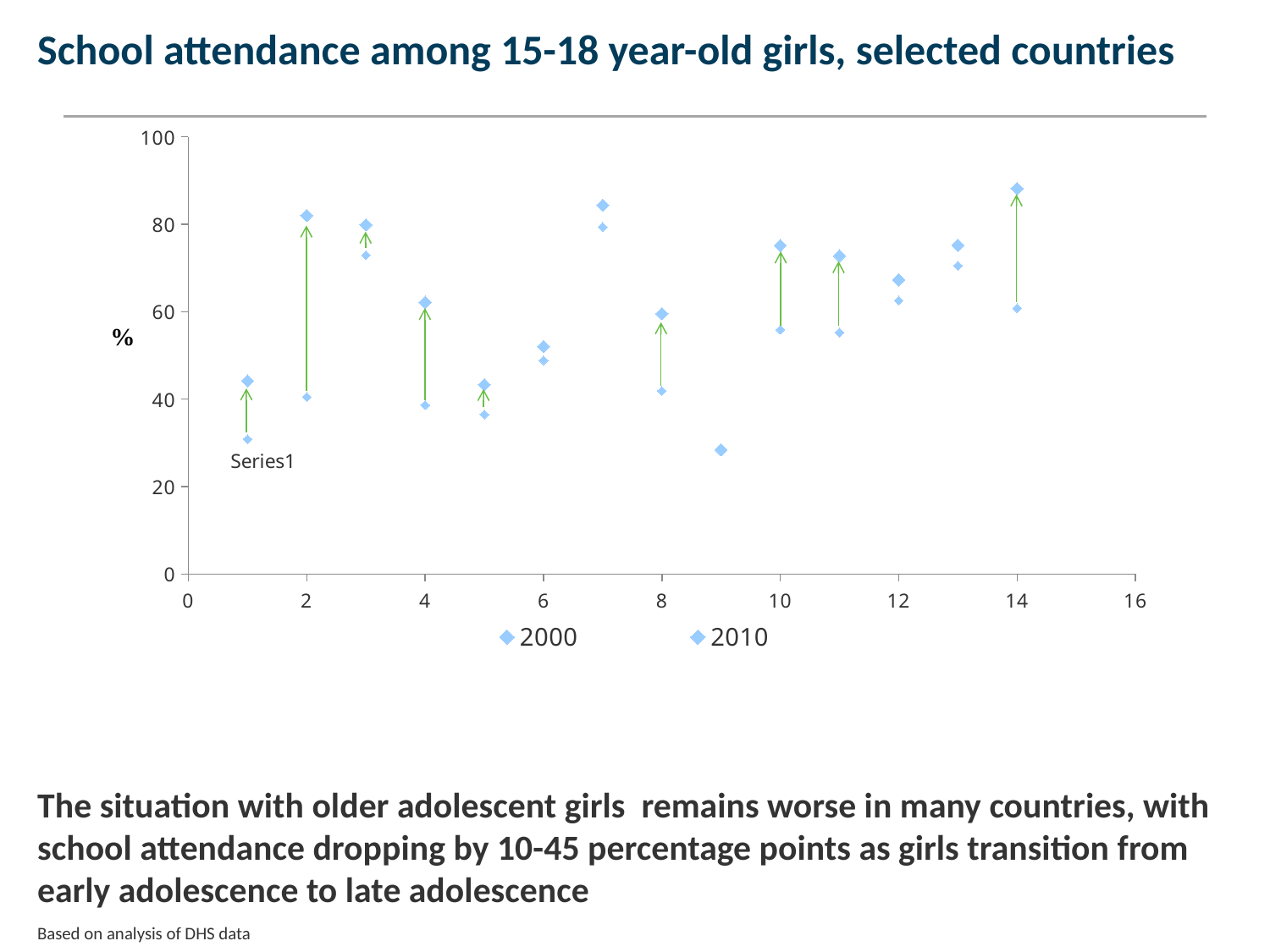
Is the single point plotted at x = 9 greater or less than 40? less What kind of chart is shown on the slide? scatter chart What are the two series named in the legend? 2000 and 2010 How many x positions have points plotted on the chart? 14 Is the higher of the two points at x = 2 greater or less than 60? greater How many series does the legend list? 2 Is the higher of the two points at x = 14 greater or less than 80? greater Which is larger: the higher point at x = 7 or the higher point at x = 6? the higher point at x = 7 At which x position is the highest plotted value found? 14 What is the label on the vertical axis? %